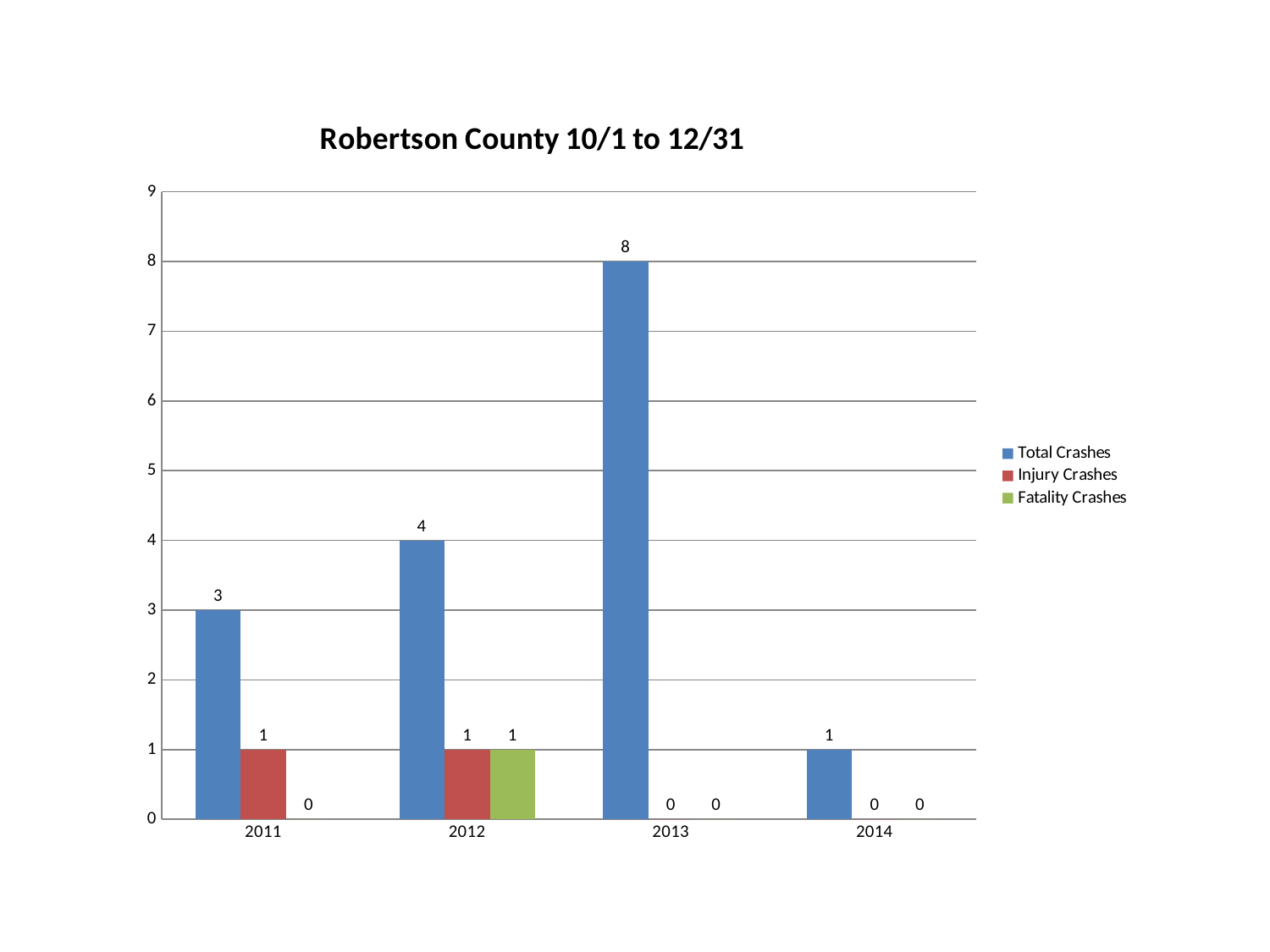
Which year has the lowest Total Crashes? 2014 How many years are shown on the x axis? 4 How many series does the legend list? 3 What is the difference between Total Crashes in 2013 and Total Crashes in 2012? 4 What is the value of Injury Crashes for 2012? 1 What is the value of Total Crashes for 2014? 1 What is the title of the chart? Robertson County 10/1 to 12/31 What is the value of Fatality Crashes for 2011? 0 What is the value of Total Crashes for 2013? 8 Which year has the highest Total Crashes? 2013 What kind of chart is shown on the slide? bar chart Which is larger, Total Crashes in 2011 or Total Crashes in 2012? 2012